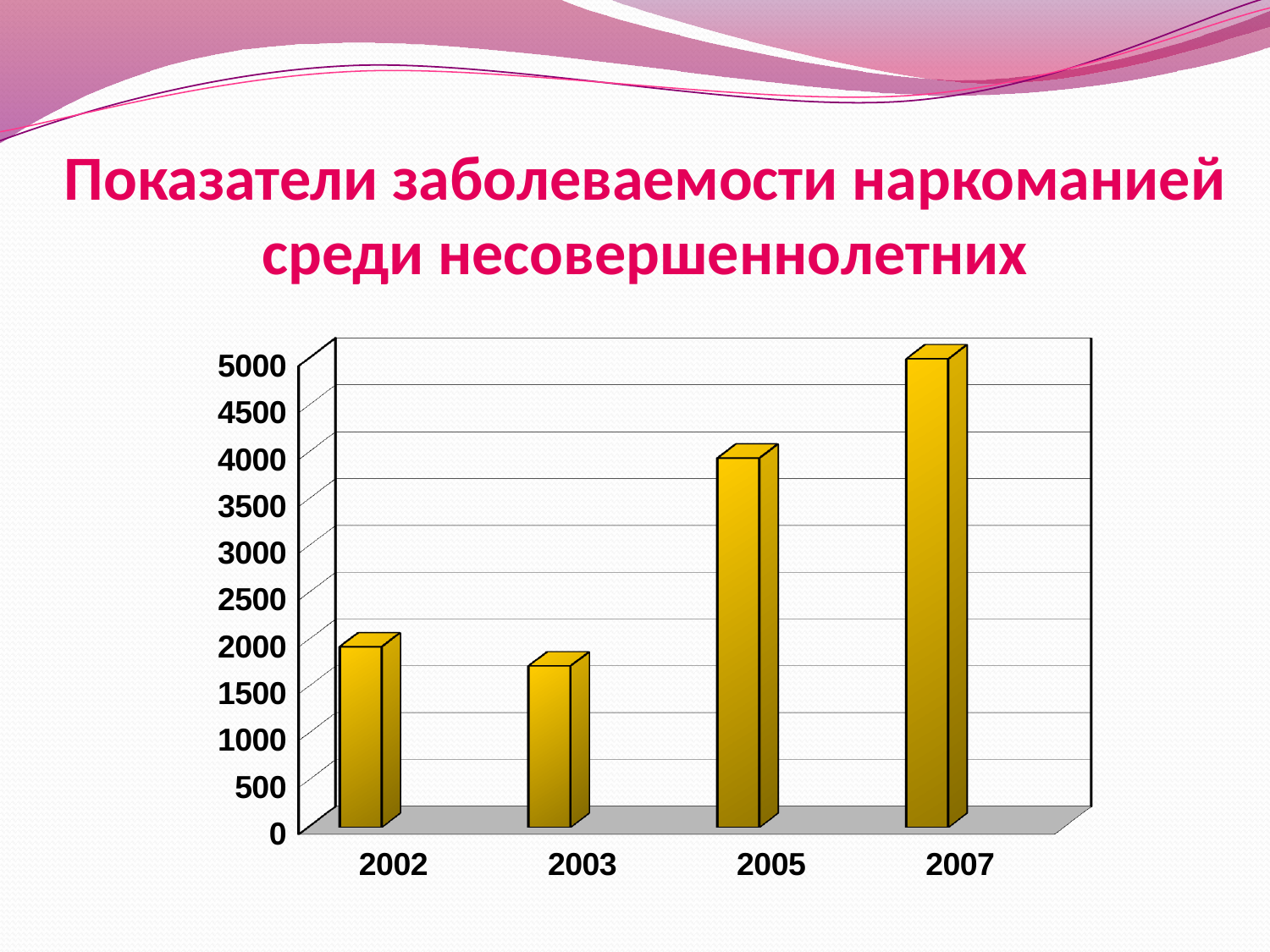
How many years (categories) are plotted on the chart? 4 Which year has the lowest value on the chart? 2003 Is the value for 2003 greater or less than 2500? less What kind of chart is shown on the slide? bar chart Which year has the larger value, 2005 or 2007? 2007 Is the value for 2007 greater or less than 4500? greater What is the highest value shown on the vertical axis? 5000 Is the value for 2002 greater or less than 1500? greater Which year has the larger value, 2002 or 2003? 2002 What is the title of the slide containing the chart? Показатели заболеваемости наркоманией среди несовершеннолетних Which year has the highest value on the chart? 2007